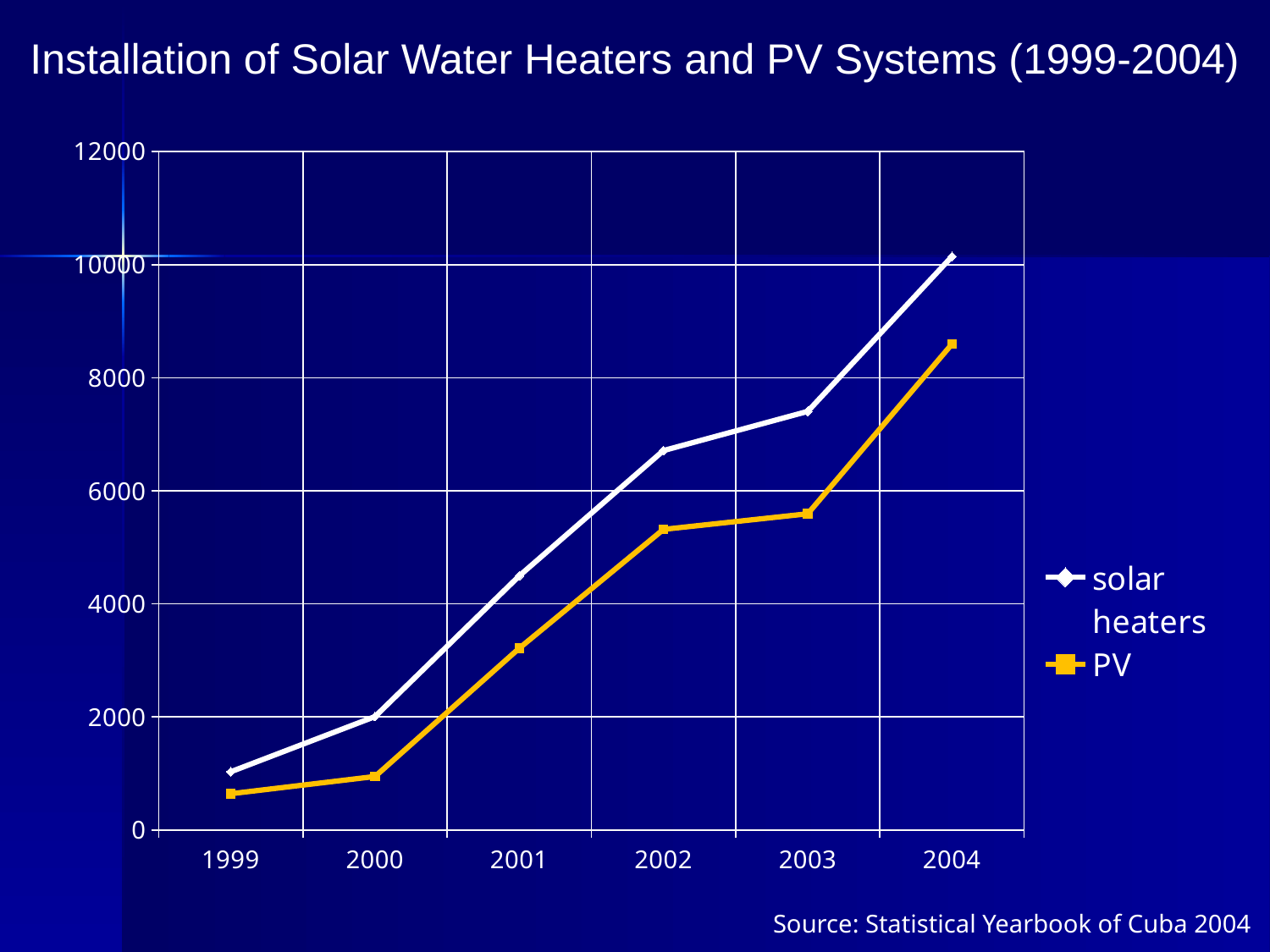
Is the value for solar heaters in 2002 greater or less than 6000? greater How many series does the legend list? 2 How many years are plotted along the x axis? 6 What kind of chart is shown on the slide? line chart Is the value for PV in 2002 greater or less than 6000? less Do the values for PV rise or fall from 1999 to 2004? rise What is the title of the chart? Installation of Solar Water Heaters and PV Systems (1999-2004) Which year has the highest value for solar heaters? 2004 Is the value for PV in 2004 greater or less than 8000? greater Which series has the larger value in 2003, solar heaters or PV? solar heaters Which year has the lowest value for PV? 1999